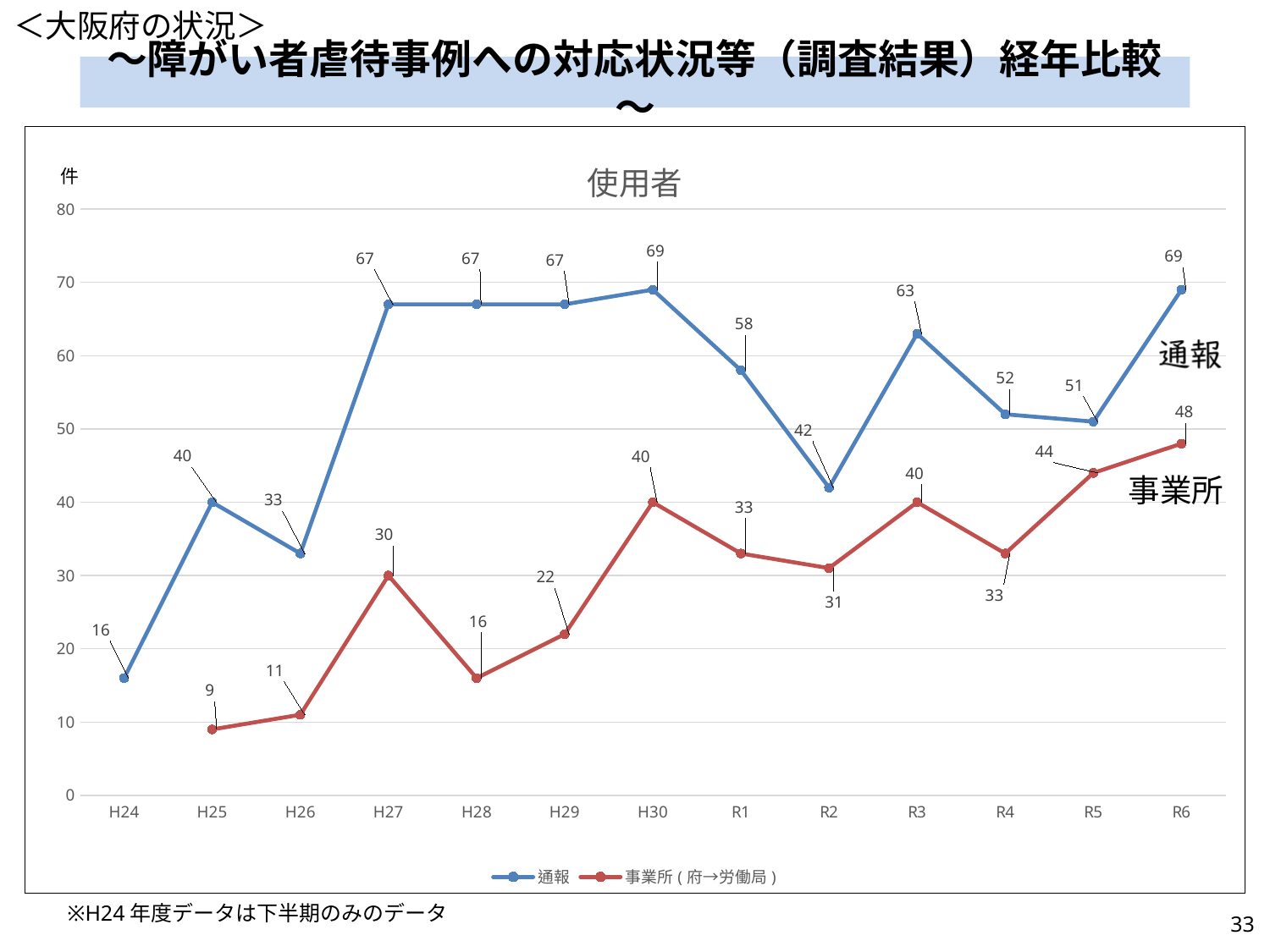
What is the value of 通報 for H27? 67 How many series does the legend list? 2 How many categories are shown on the x axis? 13 What type of chart is shown on the slide? line chart In which year is the 通報 series lowest? H24 What is the difference between 通報 and 事業所 in R6? 21 Which is larger in R3, 通報 or 事業所? 通報 What is the value of 事業所 for R5? 44 In which year is the 事業所 series highest? R6 In which year is the 事業所 series lowest? H25 What is the title of the chart? 使用者 What is the value of 通報 for R2? 42